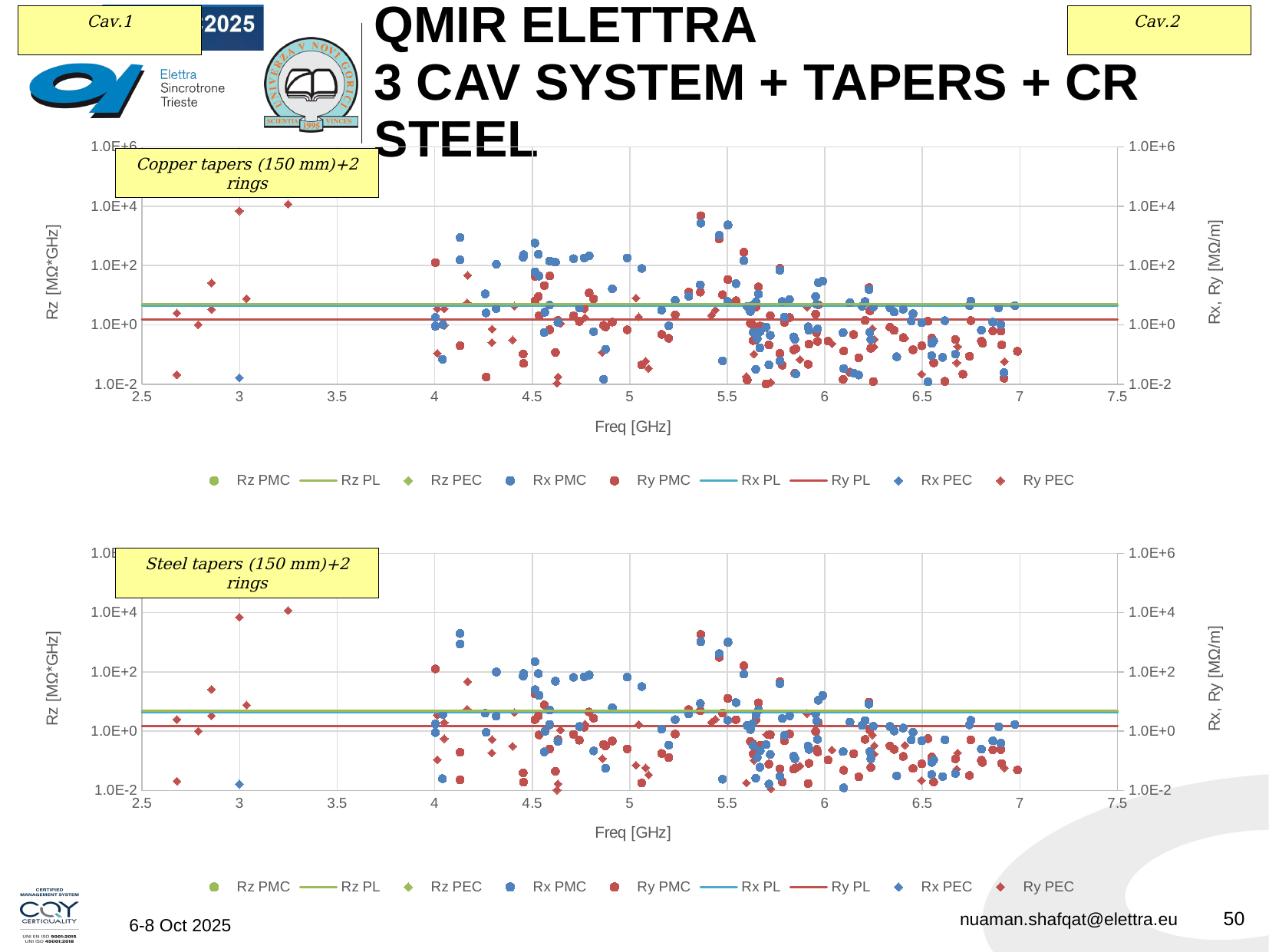
What kind of chart is the 'Steel tapers (150 mm)+2 rings' chart? scatter chart How many series does the legend of the 'Copper tapers (150 mm)+2 rings' chart list? 9 What kind of chart is the 'Copper tapers (150 mm)+2 rings' chart? scatter chart In the 'Steel tapers (150 mm)+2 rings' chart, is the Ry PEC value near 3.25 GHz greater or less than 1.0E+2? greater What is the x-axis label of the 'Copper tapers (150 mm)+2 rings' chart? Freq [GHz] How many series does the legend of the 'Steel tapers (150 mm)+2 rings' chart list? 9 In the 'Steel tapers (150 mm)+2 rings' chart, is the Rx PEC value at 3 GHz greater or less than 1.0E+0? less In the 'Copper tapers (150 mm)+2 rings' chart, is the Rx PEC value at 3 GHz greater or less than 1.0E+0? less What is the left y-axis label of the 'Steel tapers (150 mm)+2 rings' chart? Rz [MΩ*GHz]